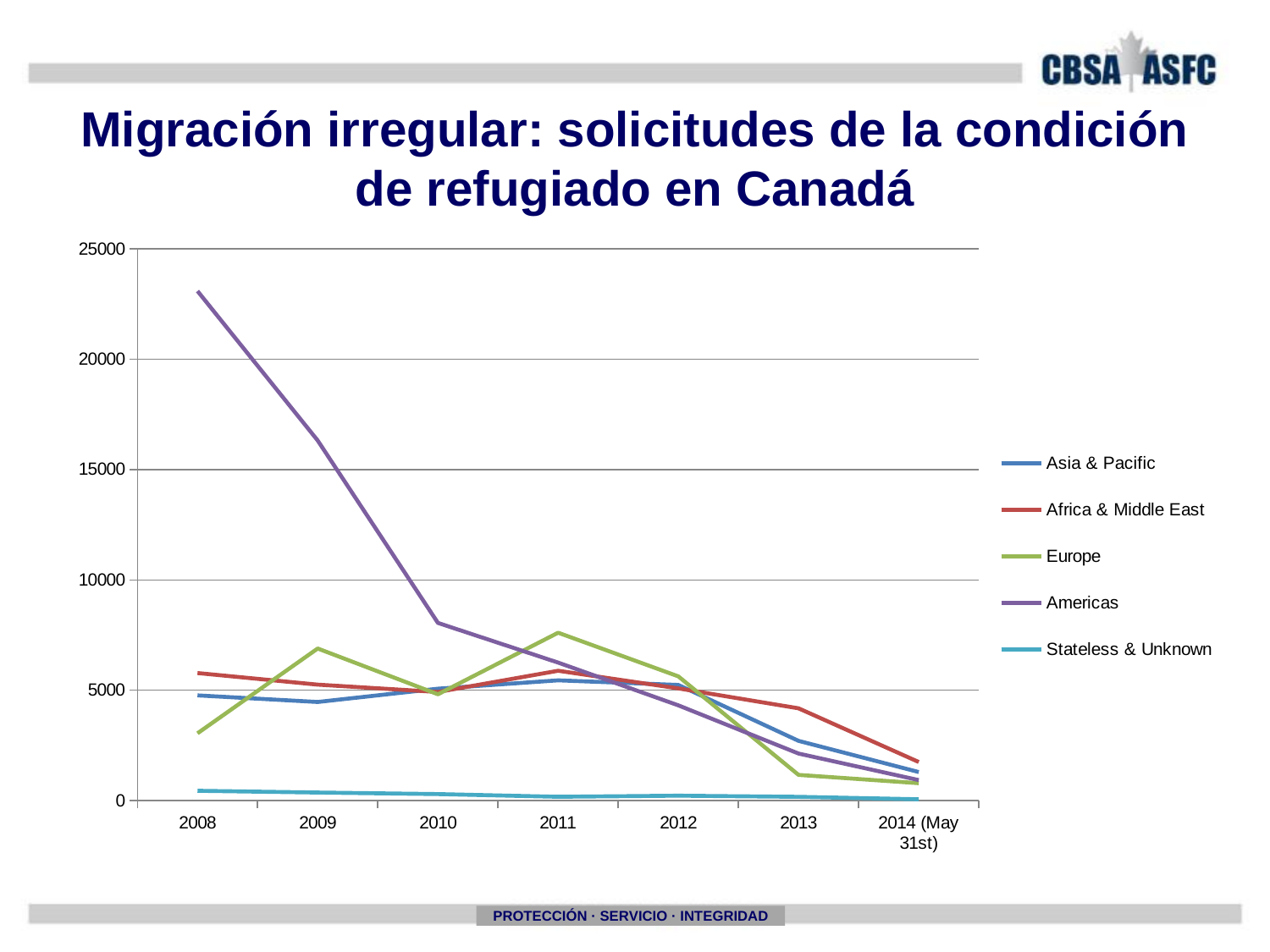
Is the value for Europe in 2011 greater or less than 5000? greater In 2009, which is larger: Europe or Asia & Pacific? Europe How many points are there along the x axis? 7 Is the value for Americas in 2010 greater or less than 10000? less What kind of chart is shown on the slide? line chart Does the Americas series rise or fall from 2008 to 2014 (May 31st)? fall Is the value for Europe in 2008 greater or less than 5000? less How many series does the legend list? 5 Which series is shown in red in the legend? Africa & Middle East Which series has the lowest values across all years? Stateless & Unknown Which series has the highest value in 2008? Americas